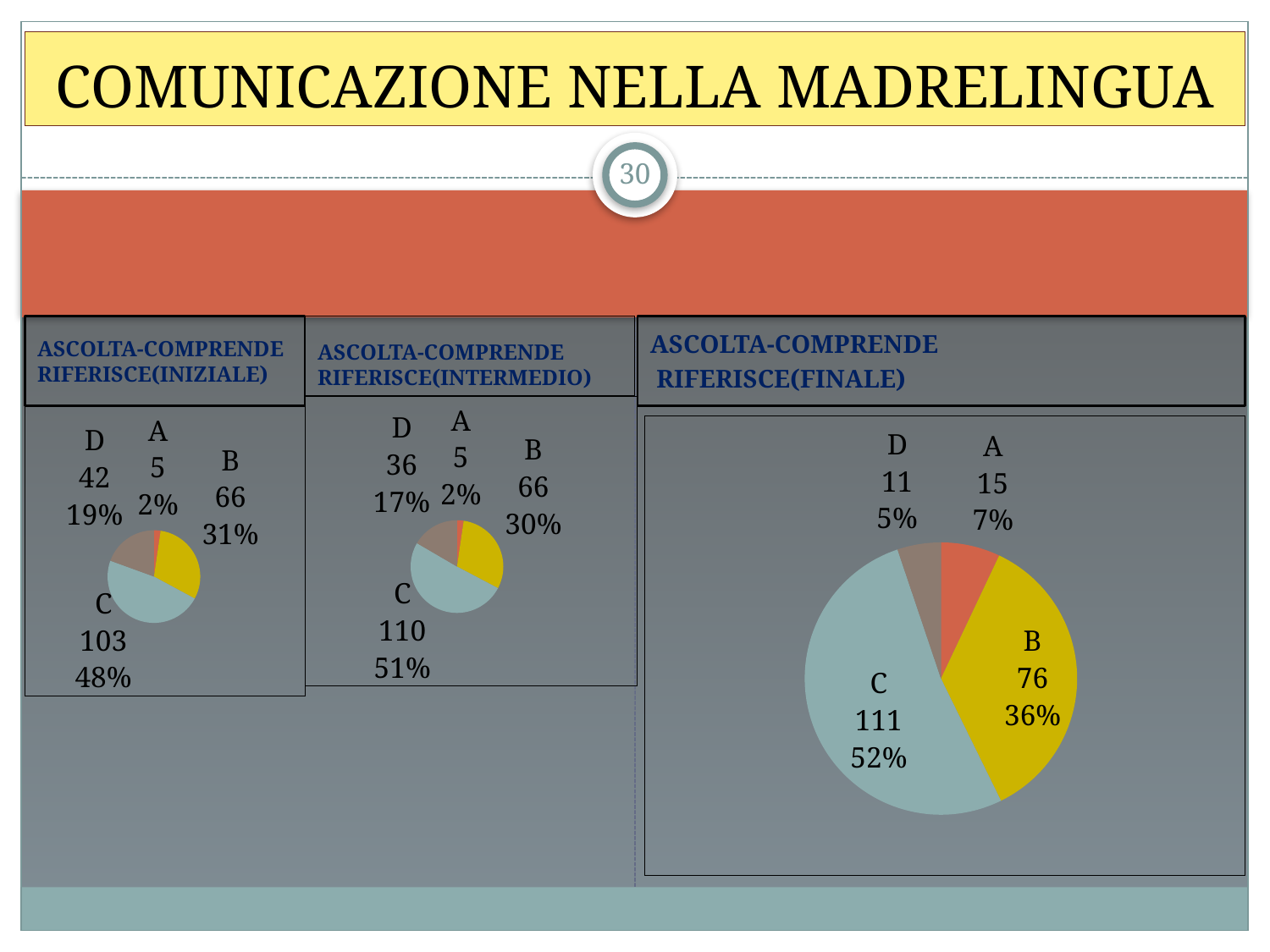
How many charts are shown on the slide? 3 In the ASCOLTA-COMPRENDE RIFERISCE(FINALE) chart, how many categories are shown? 4 What type of chart is used in the ASCOLTA-COMPRENDE RIFERISCE(FINALE) panel? Pie chart In the ASCOLTA-COMPRENDE RIFERISCE(INTERMEDIO) chart, what is the value for category D? 36 In the ASCOLTA-COMPRENDE RIFERISCE(FINALE) chart, what is the value for category B? 76 In the ASCOLTA-COMPRENDE RIFERISCE(INTERMEDIO) chart, what is the difference between the values for C and B? 44 In the ASCOLTA-COMPRENDE RIFERISCE(FINALE) chart, what percentage share does category C have? 52% In the ASCOLTA-COMPRENDE RIFERISCE(INIZIALE) chart, what is the value for category C? 103 In the ASCOLTA-COMPRENDE RIFERISCE(FINALE) chart, which is larger, the value for A or the value for D? A In the ASCOLTA-COMPRENDE RIFERISCE(INIZIALE) chart, what percentage share does category B have? 31% In the ASCOLTA-COMPRENDE RIFERISCE(INTERMEDIO) chart, which category has the highest value? C In the ASCOLTA-COMPRENDE RIFERISCE(INIZIALE) chart, which category has the lowest value? A